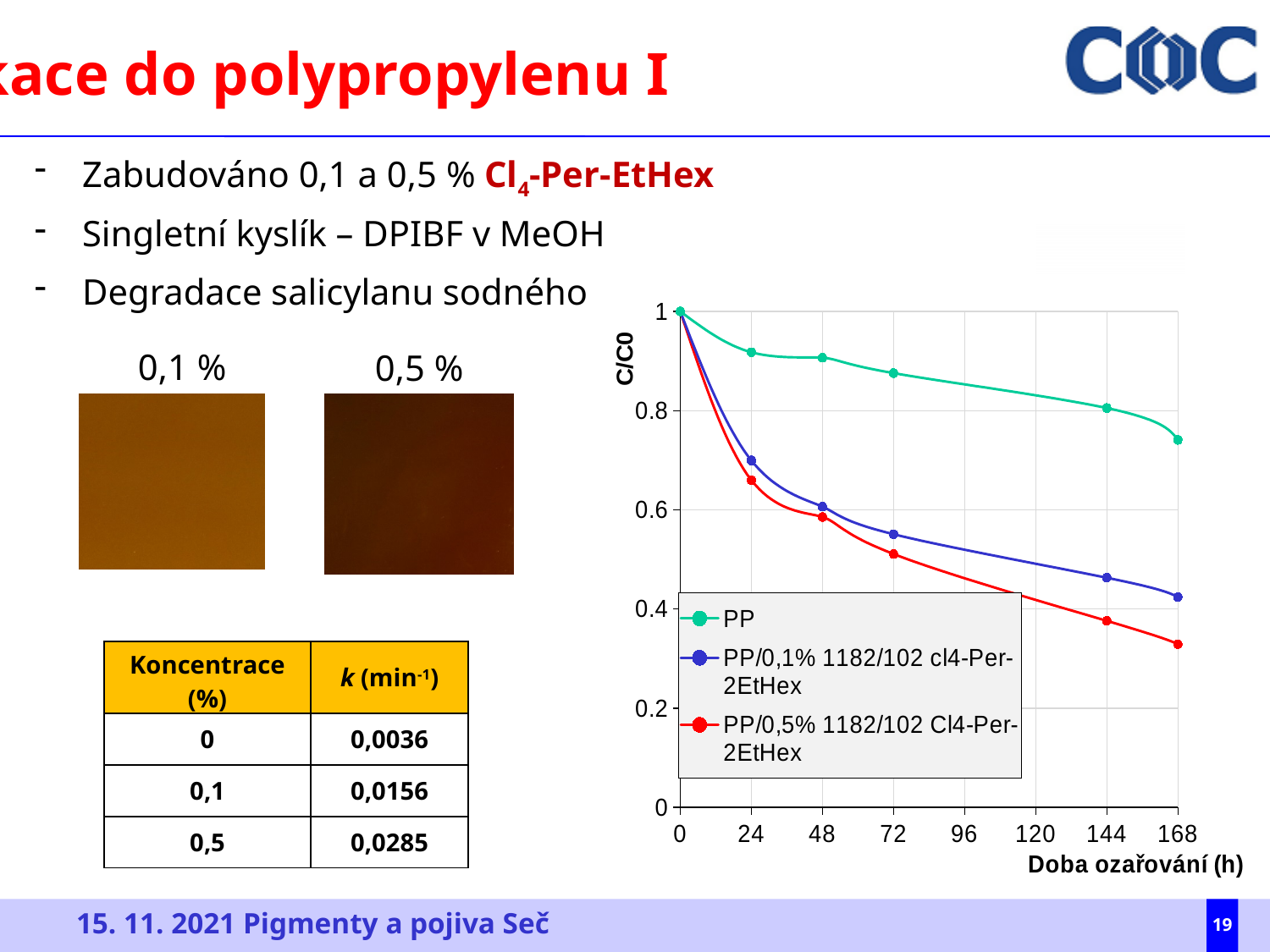
Which series has the highest C/C0 value at 168 h? PP Is the C/C0 value for PP/0,5% 1182/102 Cl4-Per-2EtHex at 168 h greater or less than 0.4? less What kind of chart is shown on the slide? line chart Is the C/C0 value for PP at 168 h greater or less than 0.6? greater Is the C/C0 value for PP at 24 h greater or less than 0.8? greater How many data points are plotted for the PP series? 6 What is the C/C0 value of the PP series at 0 h? 1 How many series does the chart legend list? 3 At 168 h, which series has the larger C/C0 value: PP or PP/0,5% 1182/102 Cl4-Per-2EtHex? PP Do the C/C0 values rise or fall as the irradiation time (Doba ozařování) increases? fall Which series has the lowest C/C0 value at 168 h? PP/0,5% 1182/102 Cl4-Per-2EtHex What is the title of the x axis of the chart? Doba ozařování (h)